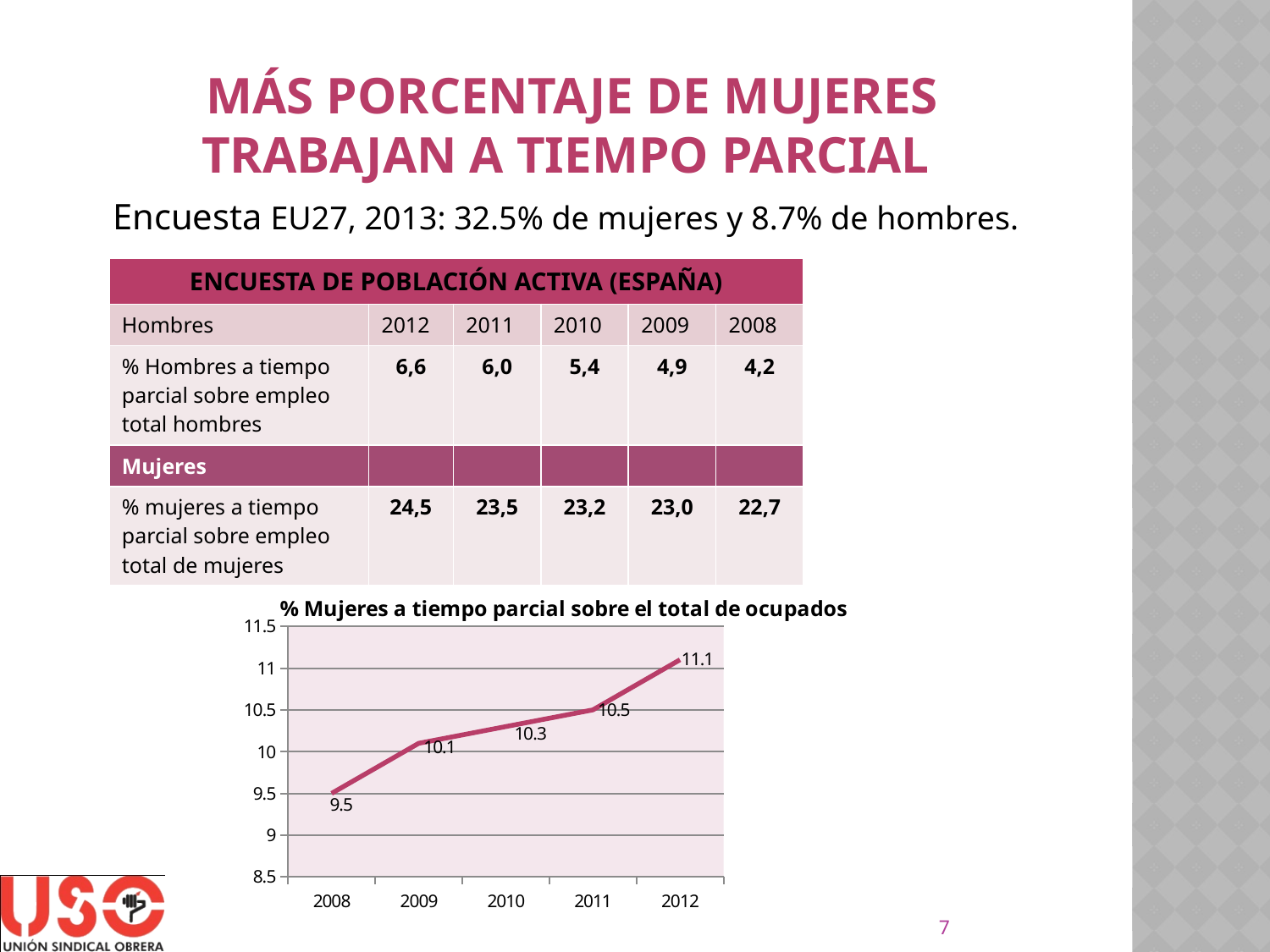
Do the values in the chart rise or fall from 2008 to 2012? rise What is the value for 2012 in the chart? 11.1 What is the value for 2008 in the chart? 9.5 What type of chart is shown on the slide? line chart What is the value for 2010 in the chart? 10.3 How many years are plotted in the chart? 5 What is the title of the chart? % Mujeres a tiempo parcial sobre el total de ocupados What is the difference between the values for 2012 and 2008 in the chart? 1.6 Is the value for 2011 in the chart greater or less than 10? greater Which is larger in the chart, the value for 2009 or the value for 2011? 2011 Which year has the highest value in the chart? 2012 Which year has the lowest value in the chart? 2008